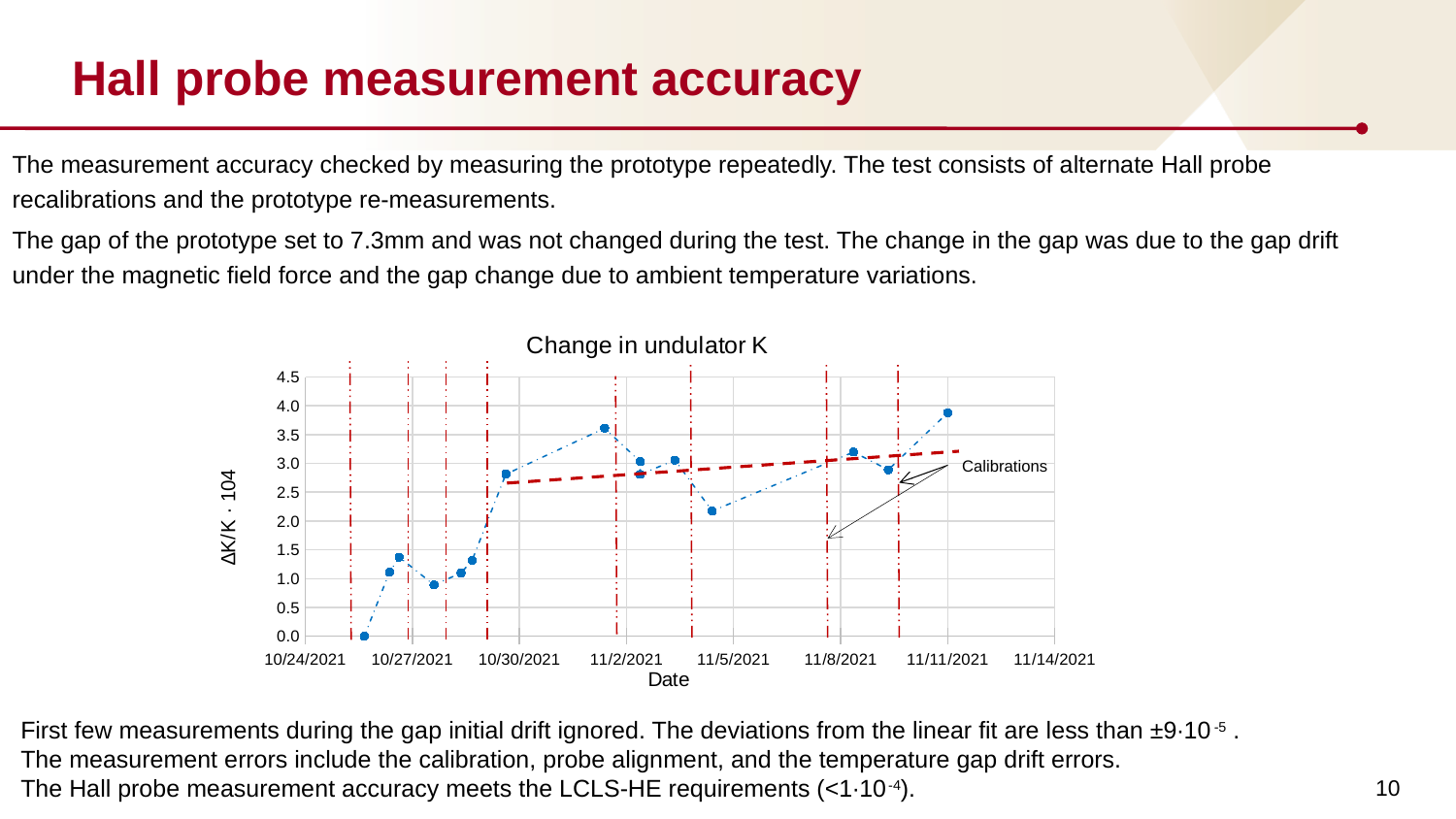
What type of chart is shown on the slide? line chart Is the plotted point near 11/5/2021 higher or lower than the plotted point near 11/8/2021? lower Is the value of the last plotted point (near 11/11/2021) greater or less than 3.5? greater Is the value of the first plotted point (just after 10/24/2021) greater or less than 0.5? less Does the red dashed linear fit line rise or fall from left to right? rise Do the plotted ΔK/K values generally rise or fall from left to right along the date axis? rise Is the value of the plotted point just before 10/27/2021 greater or less than 2.0? less What is the label of the x axis of the chart? Date Which plotted point has the highest ΔK/K value: the one near 11/2/2021 or the one near 11/11/2021? the one near 11/11/2021 What is the title of the chart? Change in undulator K